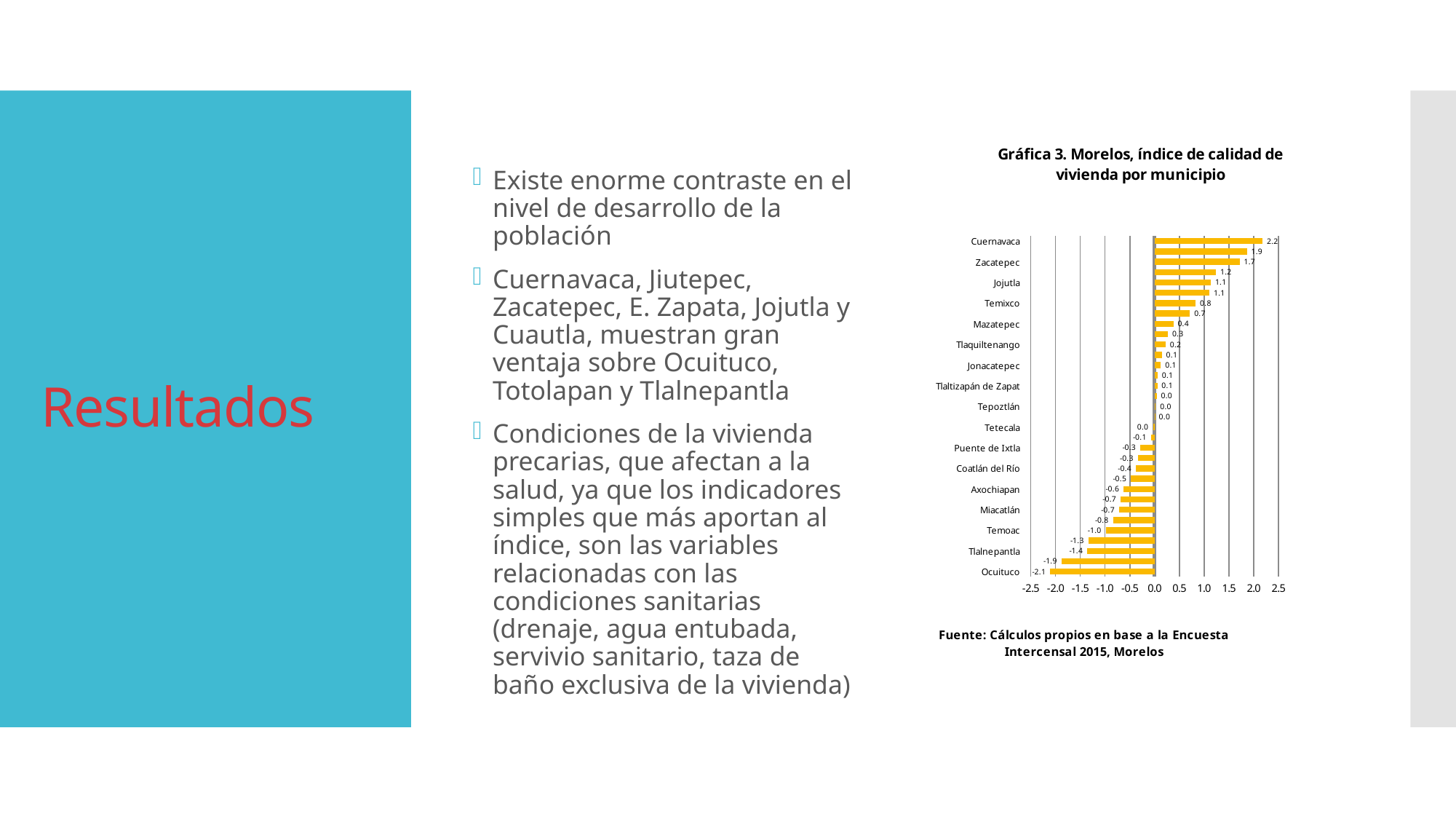
Which municipality has the lowest housing quality index? Ocuituco What is the difference between the values for Cuernavaca and Zacatepec? 0.5 What is the value shown for Zacatepec? 1.7 What type of chart is shown on the slide? bar chart What is the value shown for Temixco? 0.8 What is the housing quality index value for Cuernavaca? 2.2 Is the value for Temoac greater or less than -0.5? less What is the housing quality index value for Ocuituco? -2.1 What is the title of the chart? Gráfica 3. Morelos, índice de calidad de vivienda por municipio What is the value shown for Tlalnepantla? -1.4 Which municipality has the highest housing quality index? Cuernavaca Which has a higher index value, Jojutla or Mazatepec? Jojutla